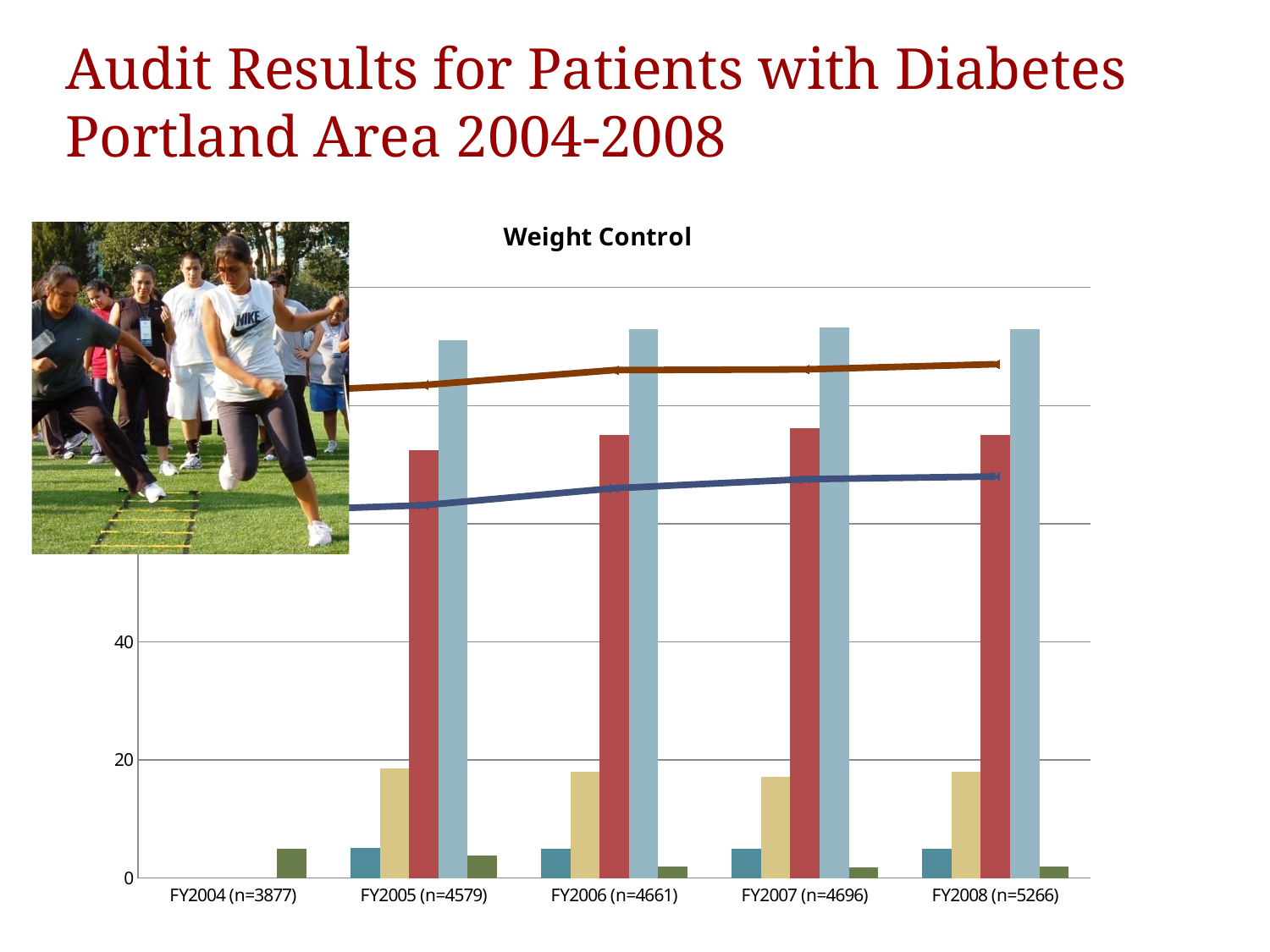
Among the green bars, which fiscal year has the highest value? FY2004 (n=3877) Which line sits higher on the chart, the brown line or the dark blue line? The brown line Is the value of the light blue bar for FY2008 (n=5266) greater or less than 40? greater What is the title of the chart? Weight Control Is the value of the red bar for FY2005 (n=4579) greater or less than 40? greater Among the red bars, which fiscal year has the lowest value? FY2005 (n=4579) What kind of chart is the Weight Control chart? A bar chart combined with line series How many fiscal-year categories are shown on the x axis of the Weight Control chart? 5 Does the brown line rise or fall from FY2005 to FY2008? It rises Is the value of the tan bar for FY2006 (n=4661) greater or less than 20? less In FY2007 (n=4696), which bar is taller, the red bar or the light blue bar? The light blue bar